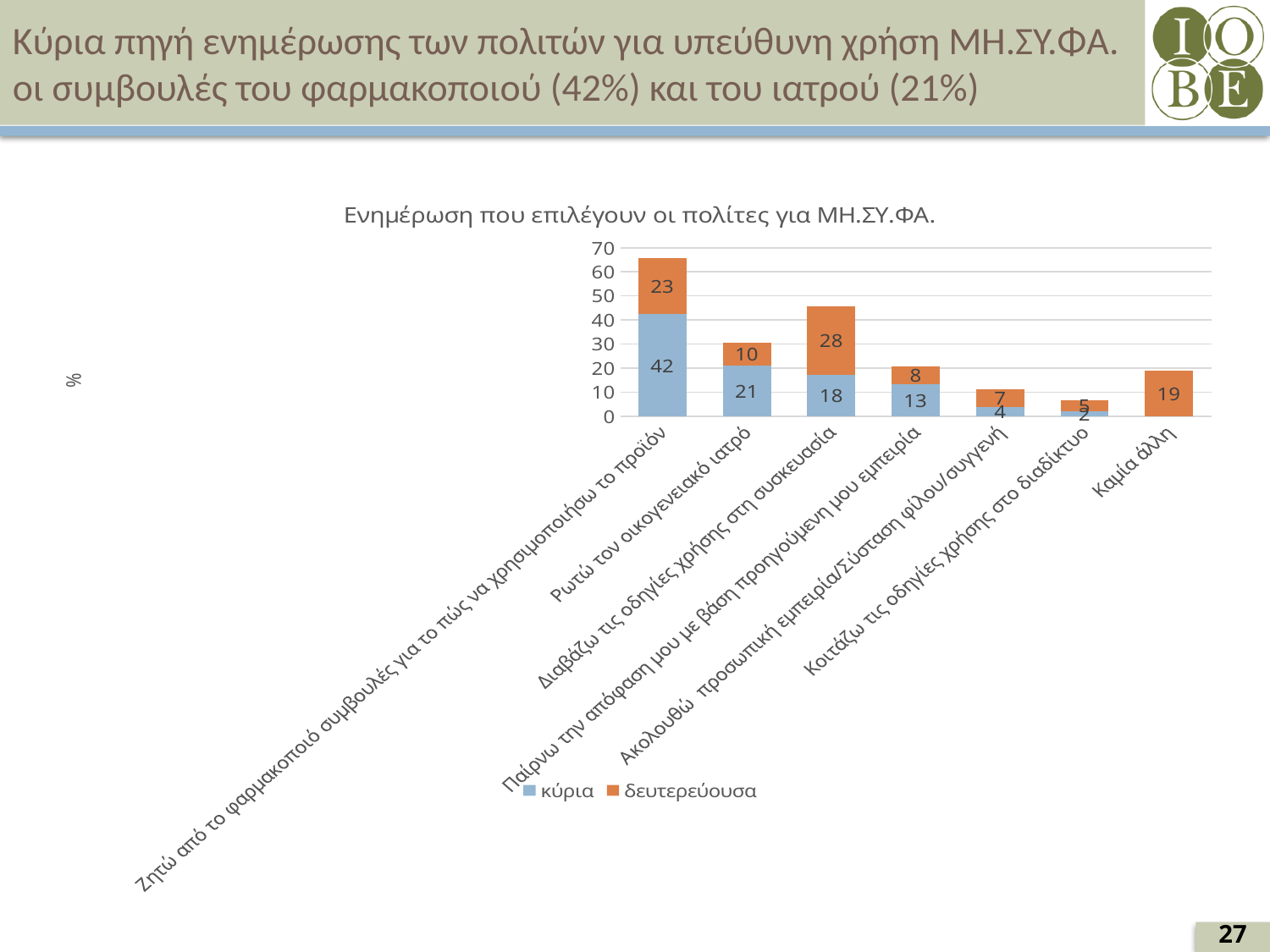
What is the total of the stacked bar for 'Ζητώ από το φαρμακοποιό συμβουλές για το πώς να χρησιμοποιήσω το προϊόν'? 65 Which category has the highest κύρια value? Ζητώ από το φαρμακοποιό συμβουλές για το πώς να χρησιμοποιήσω το προϊόν What is the κύρια value for 'Ρωτώ τον οικογενειακό ιατρό'? 21 Which category has the lowest κύρια value among those with a printed κύρια label? Κοιτάζω τις οδηγίες χρήσης στο διαδίκτυο How many series does the legend list? 2 What is the δευτερεύουσα value for 'Καμία άλλη'? 19 What type of chart is shown on the slide? stacked bar chart How many categories are shown on the x axis? 7 What is the title of the chart? Ενημέρωση που επιλέγουν οι πολίτες για ΜΗ.ΣΥ.ΦΑ. What is the δευτερεύουσα value for 'Διαβάζω τις οδηγίες χρήσης στη συσκευασία'? 28 Which is larger for 'Ακολουθώ προσωπική εμπειρία/Σύσταση φίλου/συγγενή': the κύρια value or the δευτερεύουσα value? δευτερεύουσα What is the difference between the κύρια values for 'Ρωτώ τον οικογενειακό ιατρό' and 'Διαβάζω τις οδηγίες χρήσης στη συσκευασία'? 3